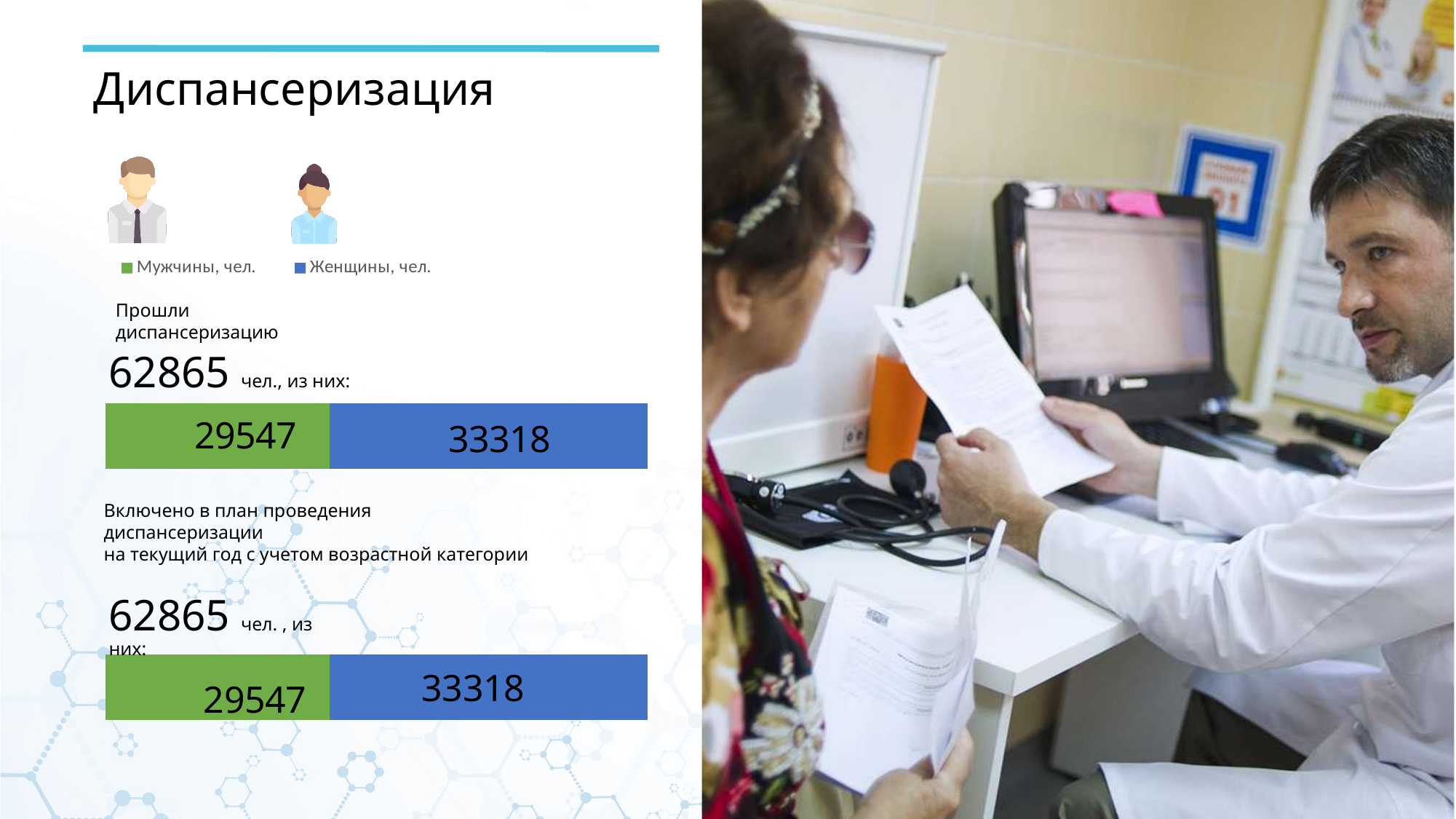
In the bottom chart (Включено в план проведения диспансеризации), what is the value for Мужчины, чел.? 29547 Which colour represents Мужчины, чел. in the legend? Green What kind of chart is the top chart? Stacked bar chart In the top chart, what is the total of the stacked bar? 62865 In the top chart (Прошли диспансеризацию), what is the value for Мужчины, чел.? 29547 In the bottom chart (Включено в план проведения диспансеризации), what is the value for Женщины, чел.? 33318 How many series does the legend list? 2 In the top chart, which series has the larger value, Мужчины or Женщины? Женщины In the bottom chart, what is the total of the stacked bar? 62865 In the top chart, what is the difference between the Женщины and Мужчины values? 3771 In the top chart (Прошли диспансеризацию), what is the value for Женщины, чел.? 33318 Which colour represents Женщины, чел. in the legend? Blue